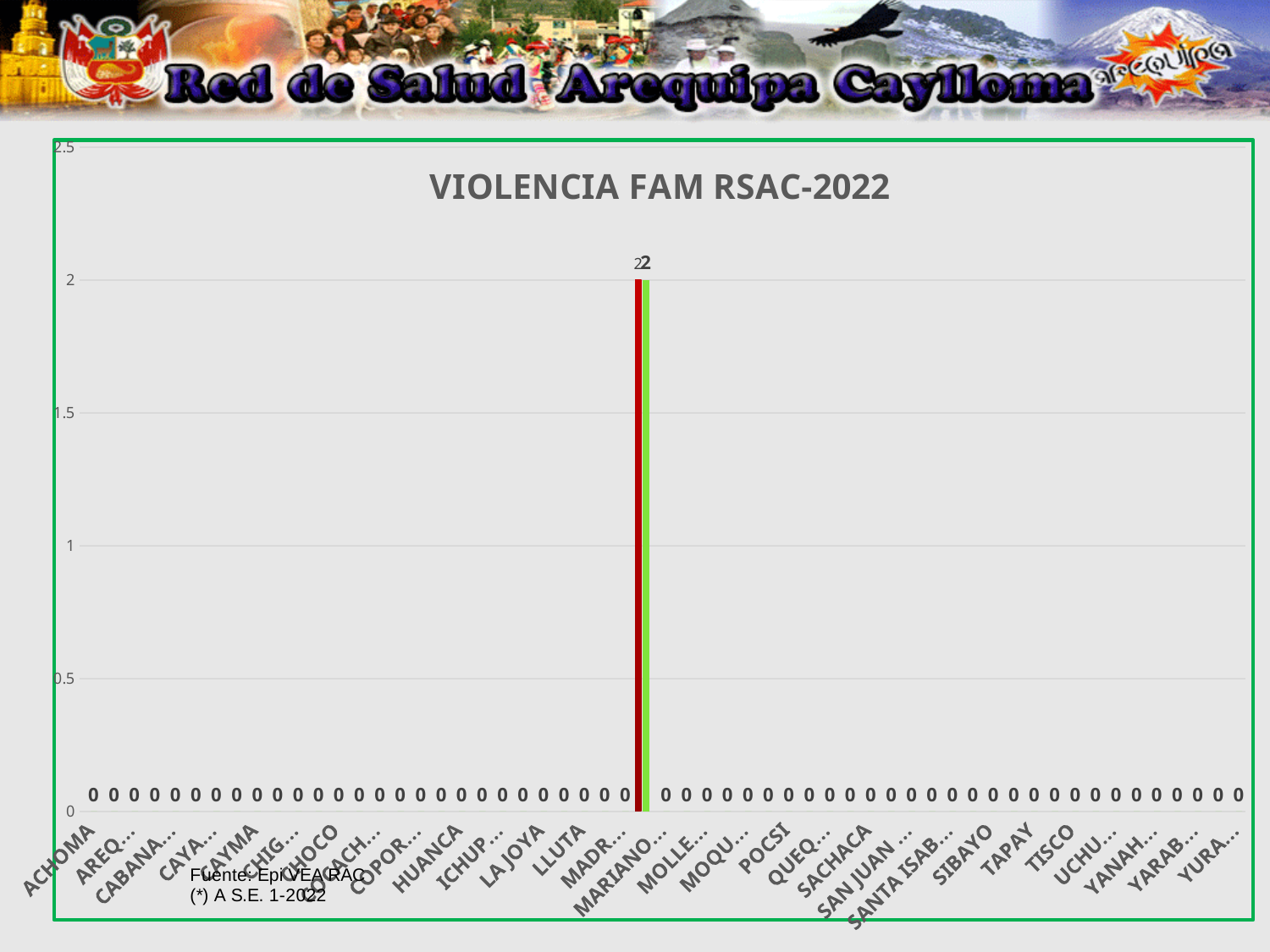
What kind of chart is shown on the slide? bar chart Is the tallest bar on the chart greater or less than 1.5? greater What value is labelled for ACHOMA? 0 What value is labelled for LLUTA? 0 Which is larger, the tallest bar's value or the value for LLUTA? the tallest bar's value What is the difference between the highest labelled value and the value for ACHOMA? 2 What is the highest tick value shown on the vertical axis? 2.5 What value is labelled for TAPAY? 0 What is the highest value labelled on the chart? 2 What is the lowest value labelled on the chart? 0 What value is labelled for SIBAYO? 0 What is the title of the chart? VIOLENCIA FAM RSAC-2022